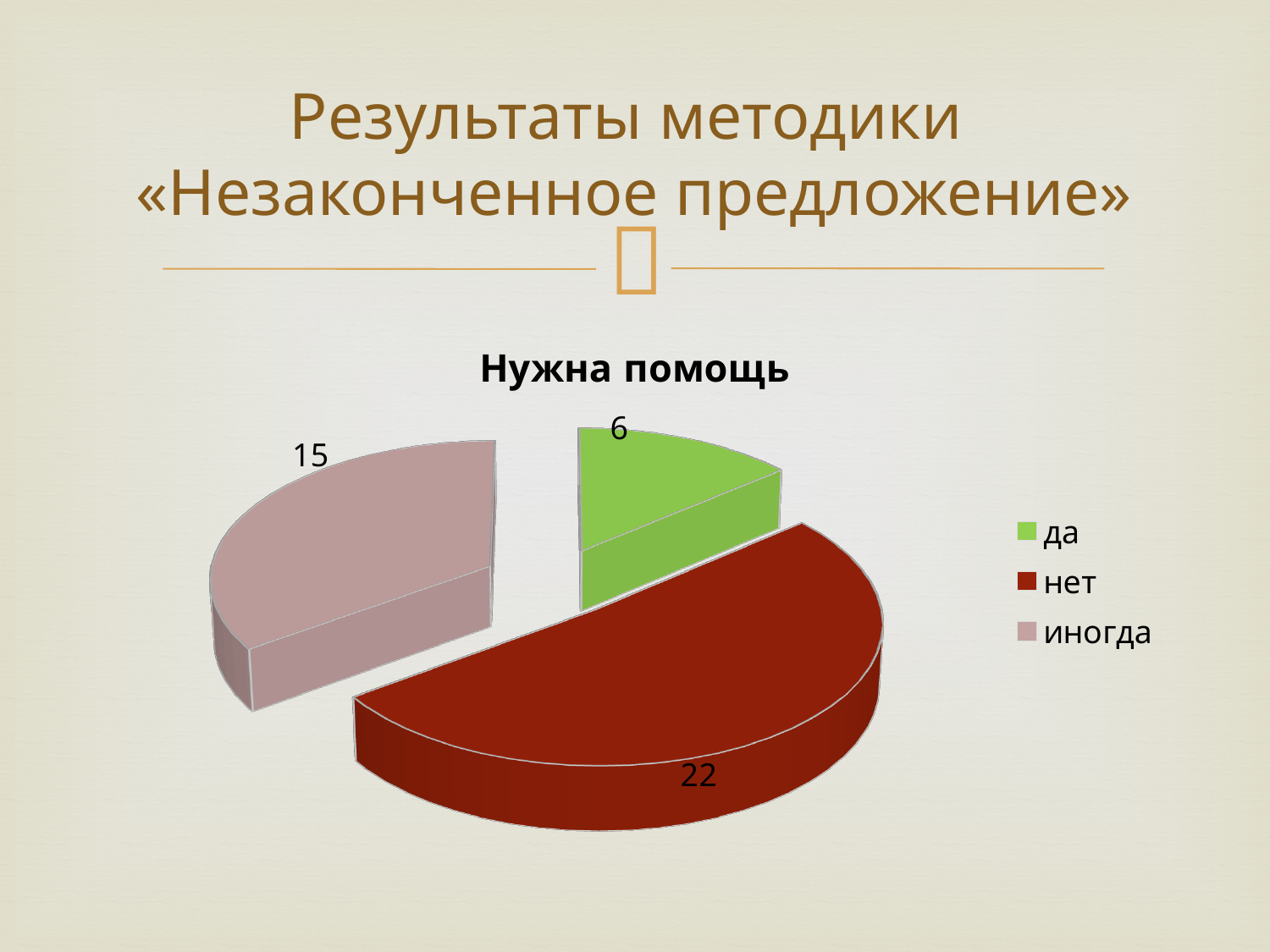
What is the title of the chart? Нужна помощь What is the value for "да"? 6 Which category has the smallest slice? да How many categories does the pie chart show? 3 What is the total of all slices in the pie chart? 43 Which category has the largest slice? нет What is the difference between the values for "нет" and "иногда"? 7 Which is larger, the value for "да" or the value for "иногда"? иногда What is the value for "нет"? 22 What kind of chart is shown on the slide? pie chart What is the value for "иногда"? 15 What is the difference between the values for "иногда" and "да"? 9